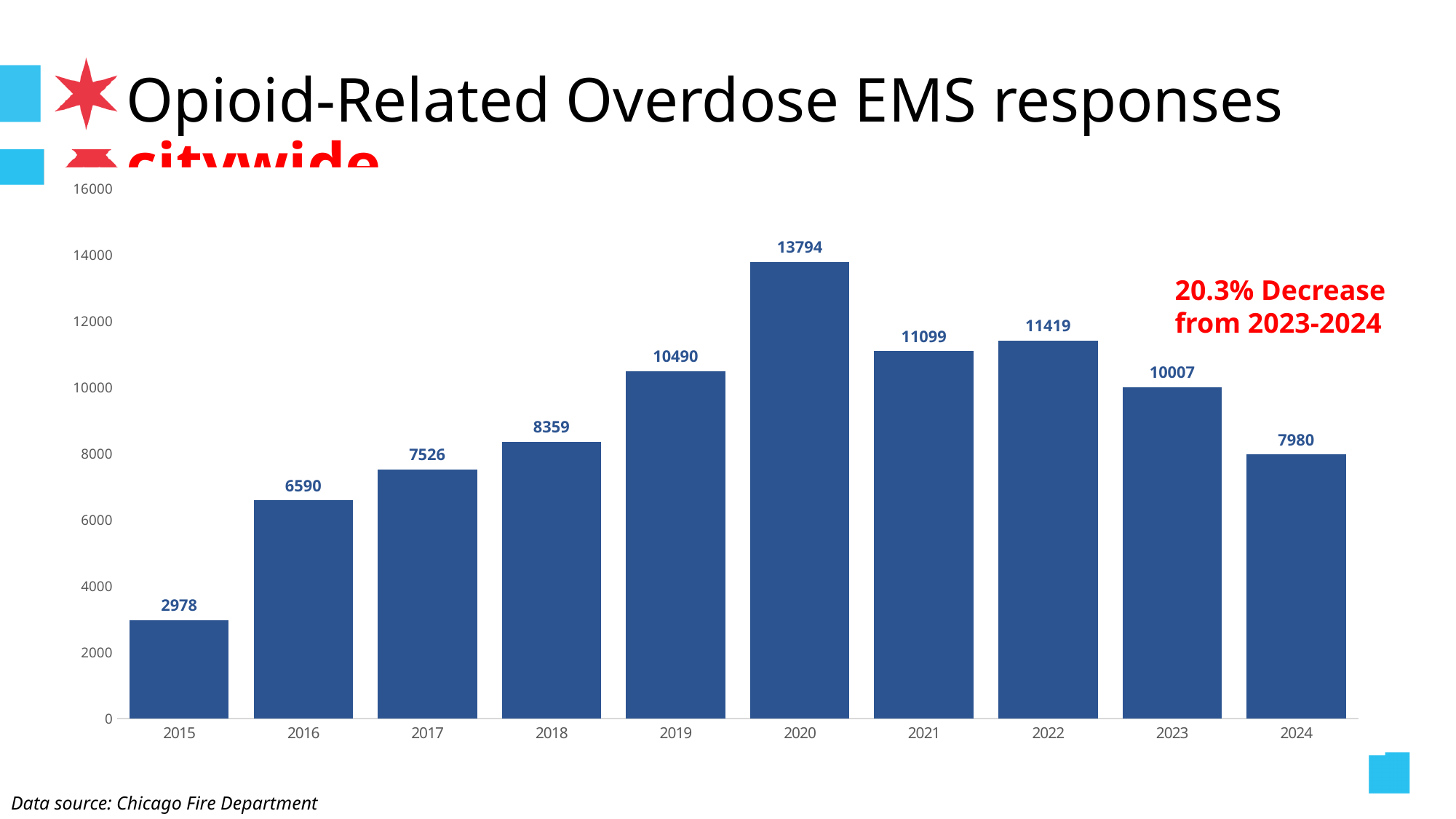
Which year had the lowest number of opioid-related overdose EMS responses? 2015 How many years are shown on the x axis of the chart? 10 Which year had the highest number of opioid-related overdose EMS responses? 2020 Which year had more opioid-related overdose EMS responses, 2021 or 2022? 2022 What was the number of opioid-related overdose EMS responses in 2015? 2978 What is the difference in EMS responses between 2023 and 2024? 2027 What percentage decrease from 2023 to 2024 is annotated on the chart? 20.3% What was the number of opioid-related overdose EMS responses in 2024? 7980 Is the value for 2019 greater or less than 10000? greater What kind of chart is shown on the slide? Bar chart Did the number of EMS responses rise or fall from 2015 to 2020? Rise What was the number of opioid-related overdose EMS responses in 2020? 13794